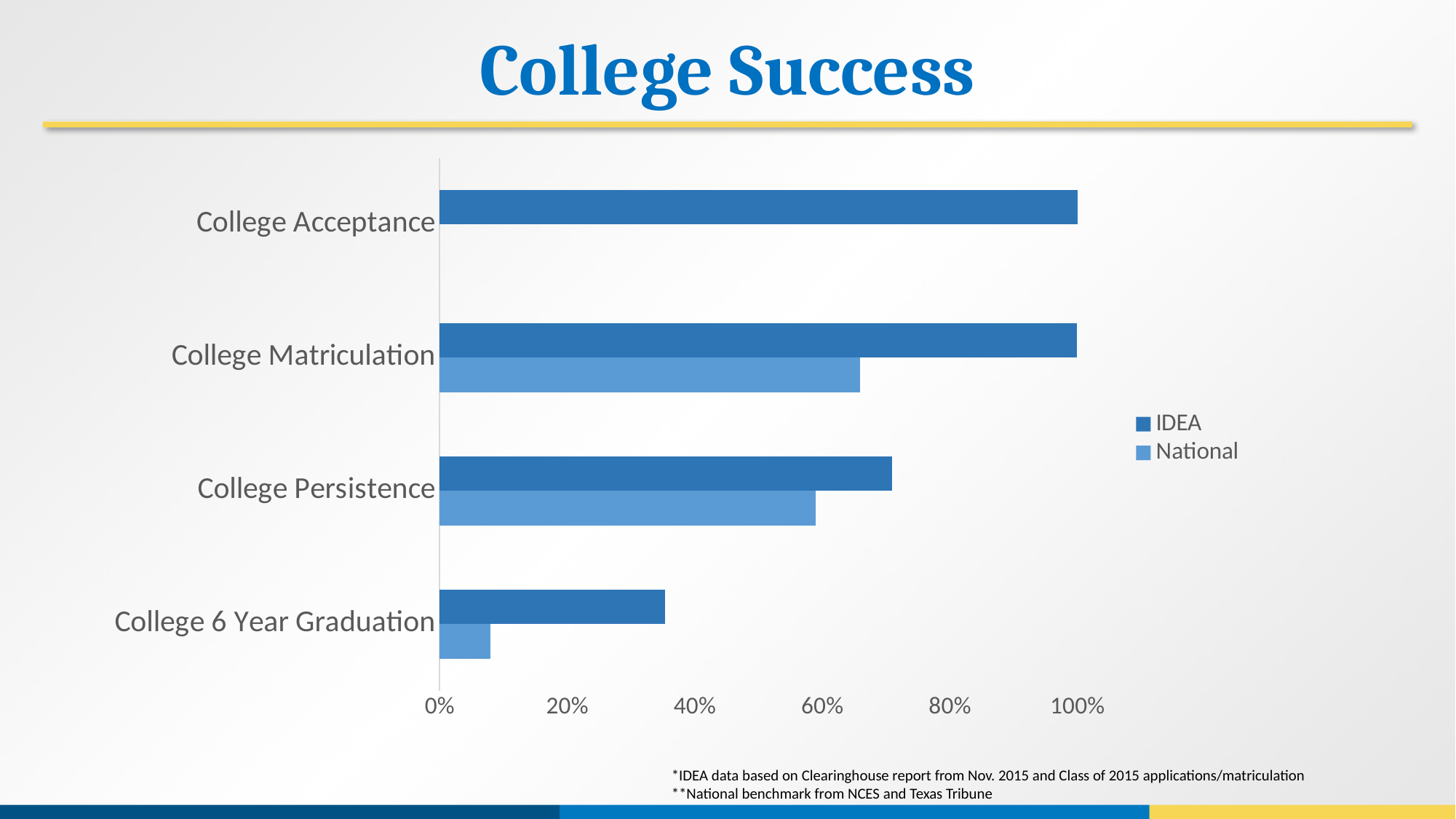
Is the National value for College 6 Year Graduation greater or less than 20%? less What is the IDEA value for College Acceptance? 100% How many categories are shown on the chart? 4 Is the National value for College Matriculation greater or less than 60%? greater For College Persistence, which is larger, the IDEA value or the National value? IDEA How many series does the legend list? 2 Which category has the lowest IDEA value? College 6 Year Graduation Is the IDEA value for College 6 Year Graduation greater or less than 40%? less What kind of chart is shown on the slide? bar chart What is the title of the slide? College Success Which category has the lowest National value? College 6 Year Graduation